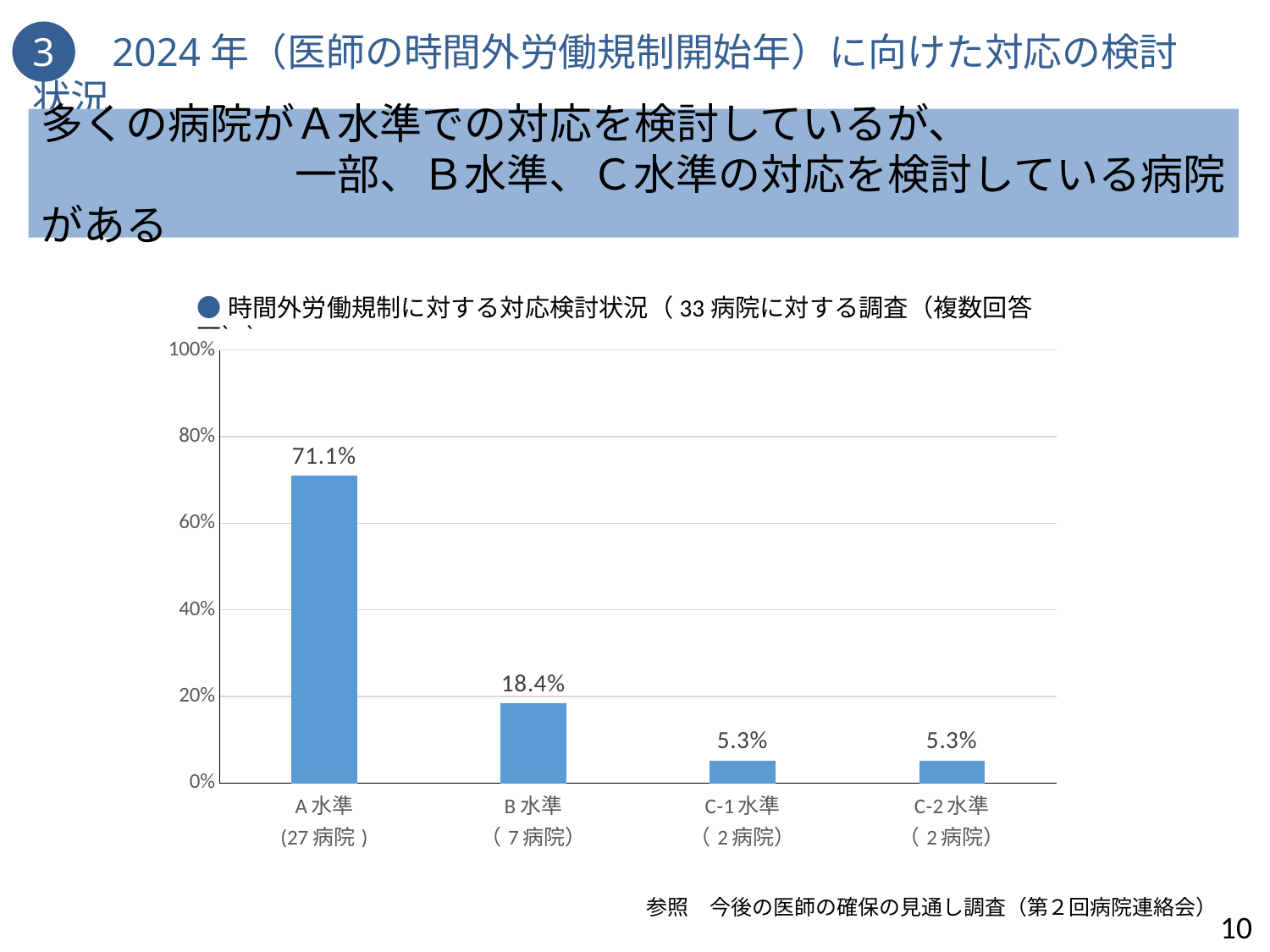
What is the value for A水準? 71.1% What is the value for C-2水準? 5.3% Which is larger, the value for B水準 or the value for C-2水準? B水準 What is the value for B水準? 18.4% How many categories are shown on the x axis? 4 Which category has the highest value? A水準 What kind of chart is shown on the slide? bar chart How many hospitals were surveyed according to the chart title? 33 What is the difference between the values for A水準 and B水準? 52.7% What is the value for C-1水準? 5.3% Is the value for A水準 greater or less than 60%? greater What is the difference between the values for B水準 and C-1水準? 13.1%